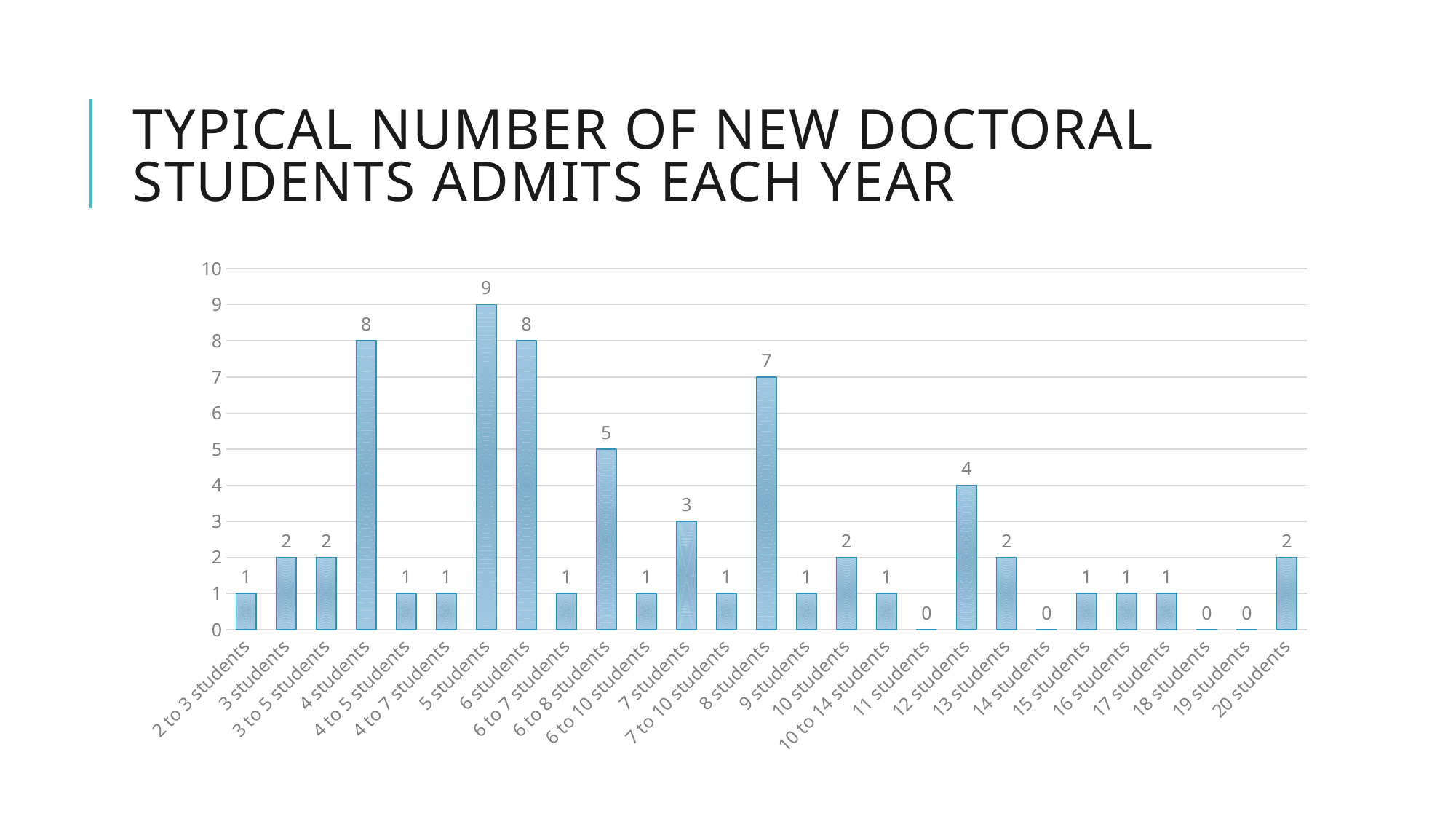
What kind of chart is shown on the slide? bar chart What is the value for "6 to 8 students"? 5 How many categories are shown on the x axis? 27 How many categories have a value of 0? 4 Which is larger, the value for "6 students" or the value for "12 students"? 6 students What is the difference between the values for "4 students" and "7 students"? 5 Which category has the highest value? 5 students What is the value for "8 students"? 7 What is the title of the chart? TYPICAL NUMBER OF NEW DOCTORAL STUDENTS ADMITS EACH YEAR What is the difference between the values for "5 students" and "8 students"? 2 What is the value for "5 students"? 9 What is the value for "12 students"? 4